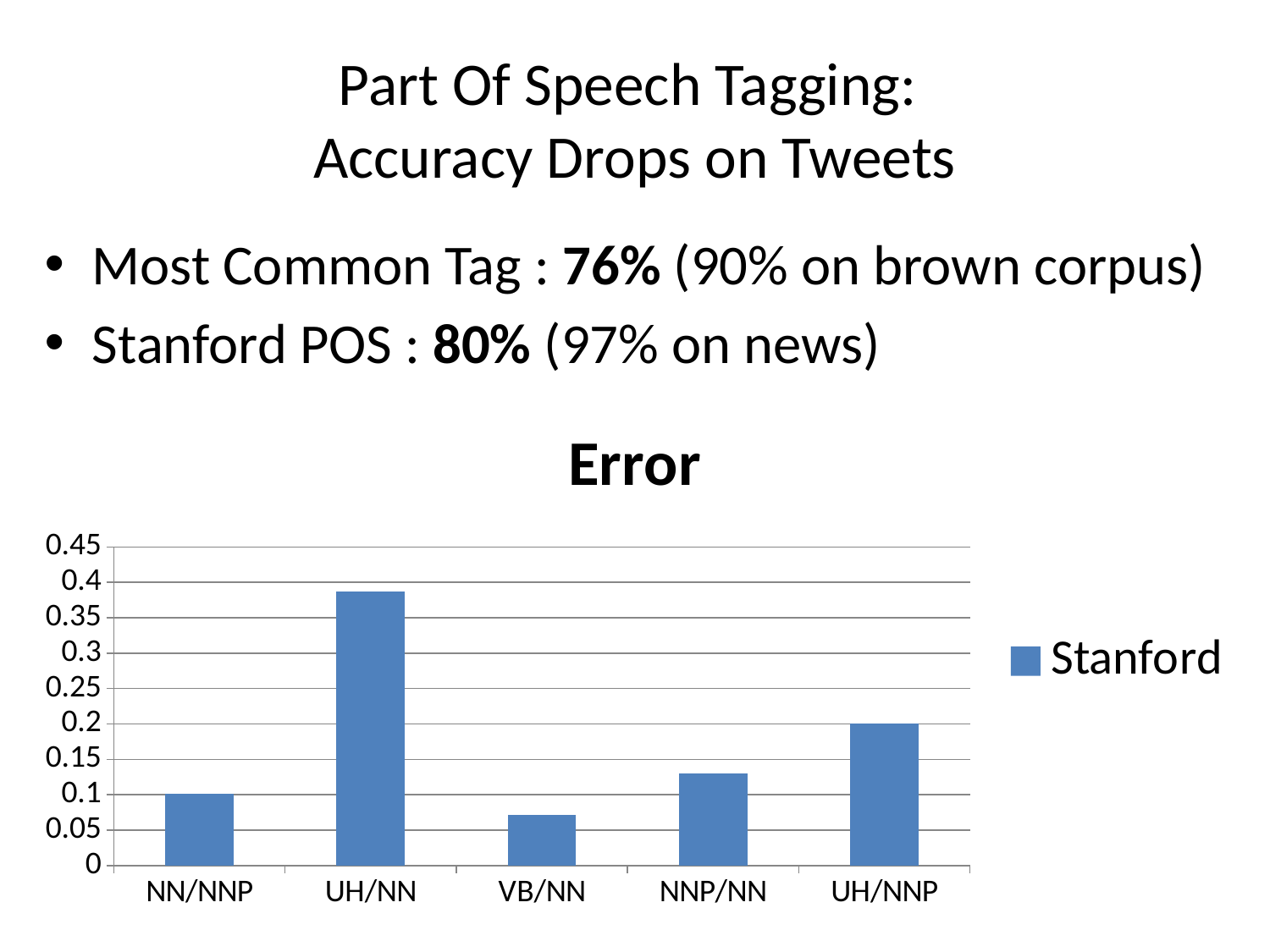
Which has a larger error, UH/NNP or NNP/NN? UH/NNP How many series does the legend of the Error chart list? 1 Which category has the lowest error in the Error chart? VB/NN How many categories are shown on the x axis of the Error chart? 5 What is the name of the series shown in the legend of the Error chart? Stanford Is the value for UH/NN greater or less than 0.35? greater What is the title of the chart on the slide? Error Which has a larger error, NN/NNP or UH/NN? UH/NN What type of chart is shown under the title "Error"? bar chart Which category has the highest error in the Error chart? UH/NN Is the value for NNP/NN greater or less than 0.15? less Is the value for VB/NN greater or less than 0.1? less